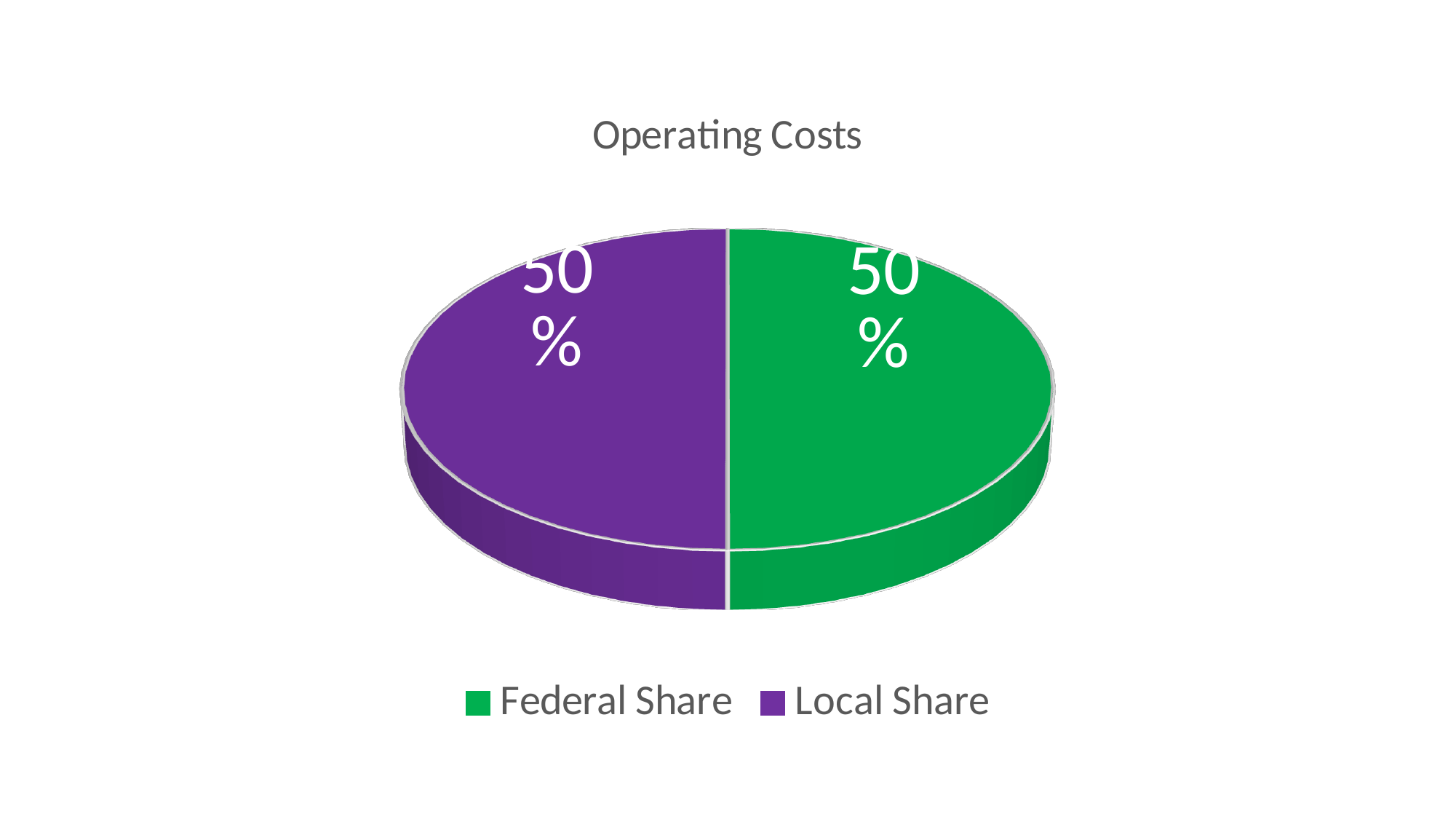
How many entries does the legend list? 2 What is the combined total of the Federal Share and Local Share slices? 100% What share of Operating Costs is the Local Share? 50% What is the difference between the Federal Share and the Local Share? 0% What is the title of the chart? Operating Costs What share of Operating Costs is the Federal Share? 50% Which colour represents the Federal Share in the chart? green How many slices does the pie chart have? 2 What kind of chart is shown on the slide? pie chart